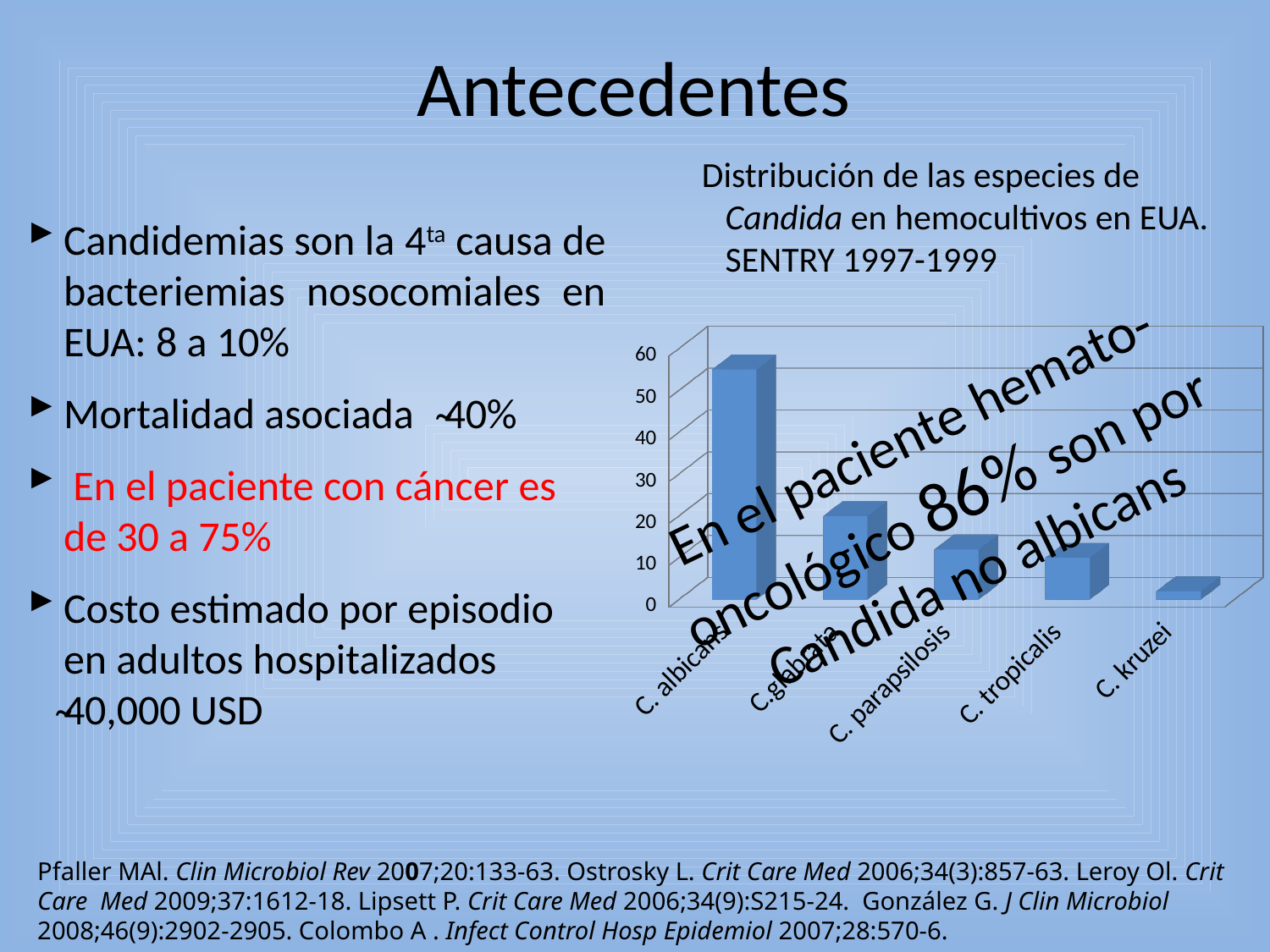
Is the value for C. albicans greater or less than 40? greater Which has a larger value, C. albicans or C. glabrata? C. albicans Do the bar values rise or fall from C. albicans to C. kruzei along the x axis? fall What time period does the chart title say the SENTRY data covers? 1997-1999 Which species has the highest bar on the chart? C. albicans Which species has the lowest bar on the chart? C. kruzei How many Candida species are plotted on the chart? 5 Which has a larger value, C. glabrata or C. kruzei? C. glabrata What kind of chart is shown on the slide? bar chart Is the value for C. parapsilosis greater or less than 20? less Is the value for C. kruzei greater or less than 10? less